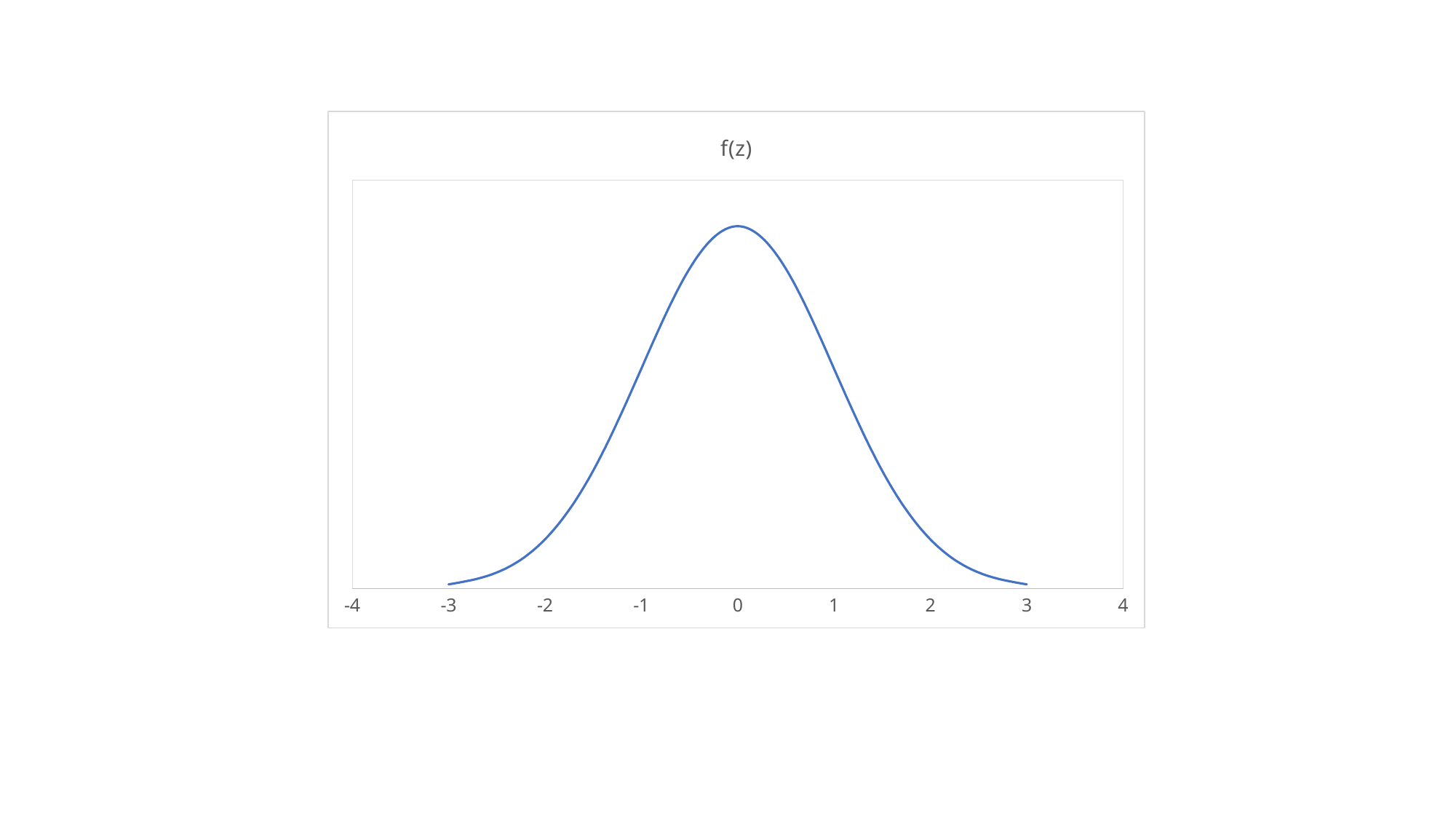
At which x-axis value does the plotted curve end on the right? 3 What is the title of the chart? f(z) Which is larger, the value of the curve at x = -1 or at x = -3? x = -1 What is the lowest x-axis tick label shown on the chart? -4 What kind of chart is shown on the slide? line chart Does the curve rise or fall as x goes from -3 to 0? rise Does the curve rise or fall as x goes from 0 to 3? fall At which x-axis value does the curve reach its highest point? 0 What is the highest x-axis tick label shown on the chart? 4 How many tick labels are shown on the x axis? 9 At which x-axis value does the plotted curve begin on the left? -3 Which is larger, the value of the curve at x = 0 or at x = 2? x = 0